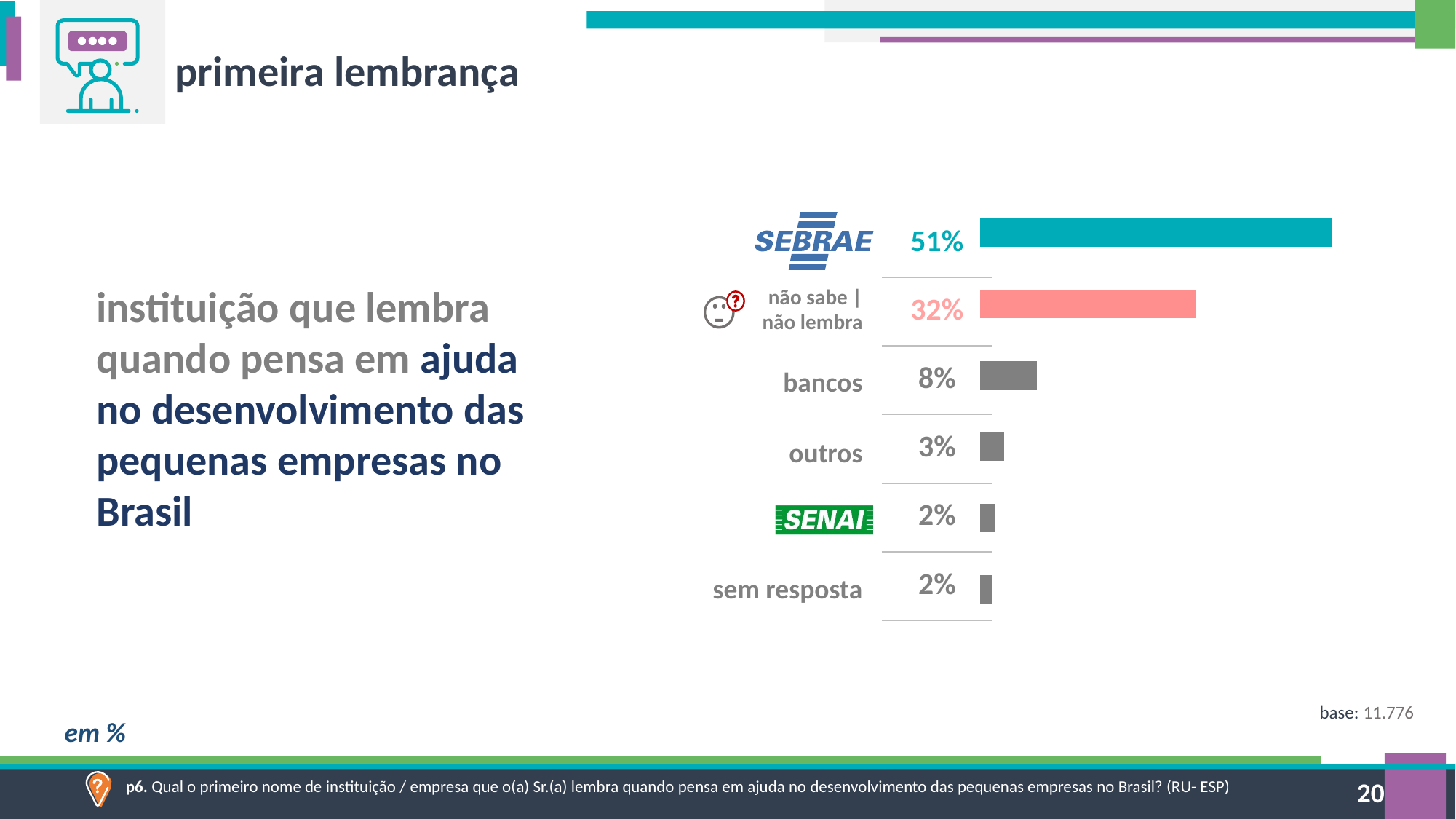
What colour is the bar for 'não sabe | não lembra'? Pink/salmon What is the difference between the SEBRAE value and the 'não sabe | não lembra' value? 19 percentage points What is the difference between the 'bancos' value and the 'outros' value? 5 percentage points What percentage is shown for 'bancos'? 8% How many categories are shown in the chart? 6 What kind of chart is shown on the slide? Bar chart What is the base (number of respondents) shown on the slide? 11.776 What percentage is shown for SEBRAE? 51% What percentage is shown for SENAI? 2% Which category has the highest value? SEBRAE Which is larger, the value for 'bancos' or the value for 'outros'? bancos What percentage is shown for 'não sabe | não lembra'? 32%